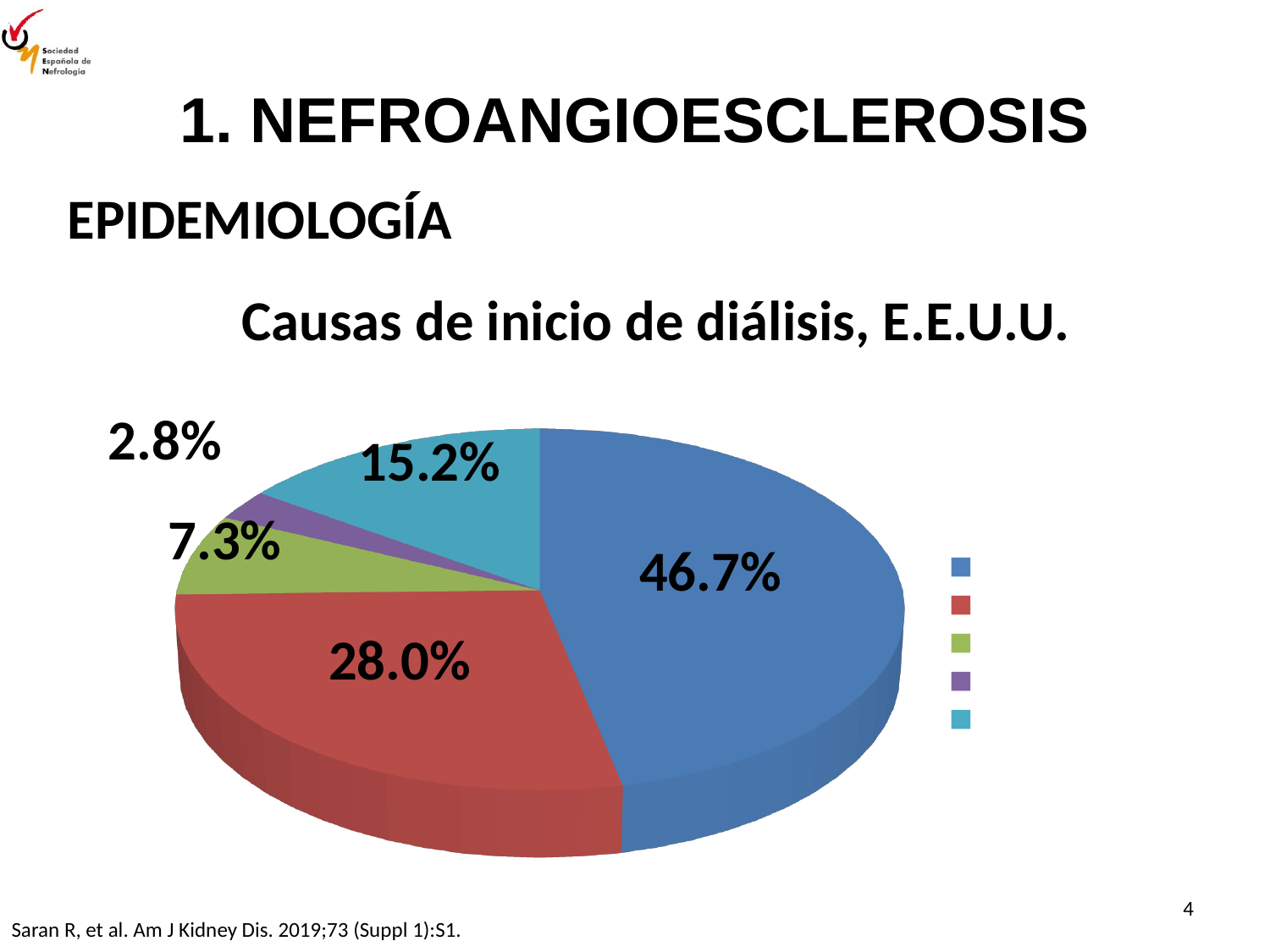
What is the smallest value shown on the pie chart? 2.8% What kind of chart is shown on the slide? pie chart How many entries does the legend of the pie chart list? 5 What value is labelled on the green slice of the pie chart? 7.3% How many slices does the pie chart have? 5 What is the largest value shown on the pie chart? 46.7% Which slice of the pie chart is larger, the red slice or the teal slice? the red slice What is the difference between the blue slice (46.7%) and the red slice (28.0%) of the pie chart? 18.7 percentage points What value is labelled on the red slice of the pie chart? 28.0% What value is labelled on the teal (light blue) slice of the pie chart? 15.2% What value is labelled on the blue slice of the pie chart? 46.7% What is the title of the pie chart? Causas de inicio de diálisis, E.E.U.U.